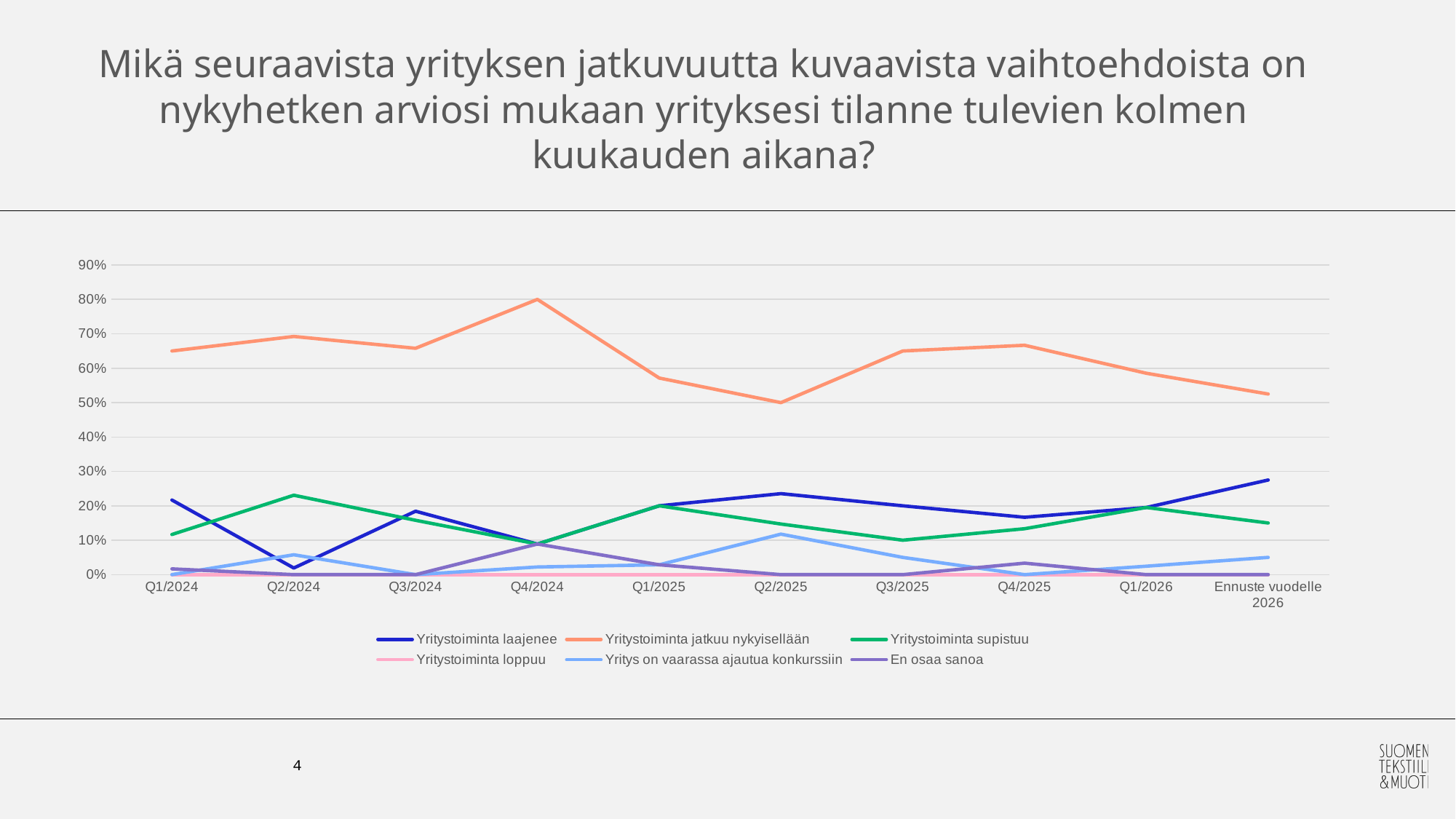
Is the value for Yritystoiminta laajenee at Ennuste vuodelle 2026 greater or less than 20%? greater At Q2/2024, which is larger: Yritystoiminta supistuu or Yritystoiminta laajenee? Yritystoiminta supistuu At which time point is the value for Yritys on vaarassa ajautua konkurssiin highest? Q2/2025 At which time point is the value for Yritystoiminta jatkuu nykyisellään highest? Q4/2024 How many series does the legend list? 6 Is the value for Yritystoiminta jatkuu nykyisellään at Q4/2024 greater or less than 70%? greater Does the value for Yritystoiminta jatkuu nykyisellään rise or fall from Q4/2024 to Q2/2025? fall Is the value for Yritystoiminta jatkuu nykyisellään at Q2/2025 greater or less than 60%? less How many time points are shown along the x axis? 10 What colour is the line for Yritystoiminta jatkuu nykyisellään? orange At Q1/2024, which is larger: Yritystoiminta laajenee or Yritystoiminta supistuu? Yritystoiminta laajenee What kind of chart is shown on the slide? line chart